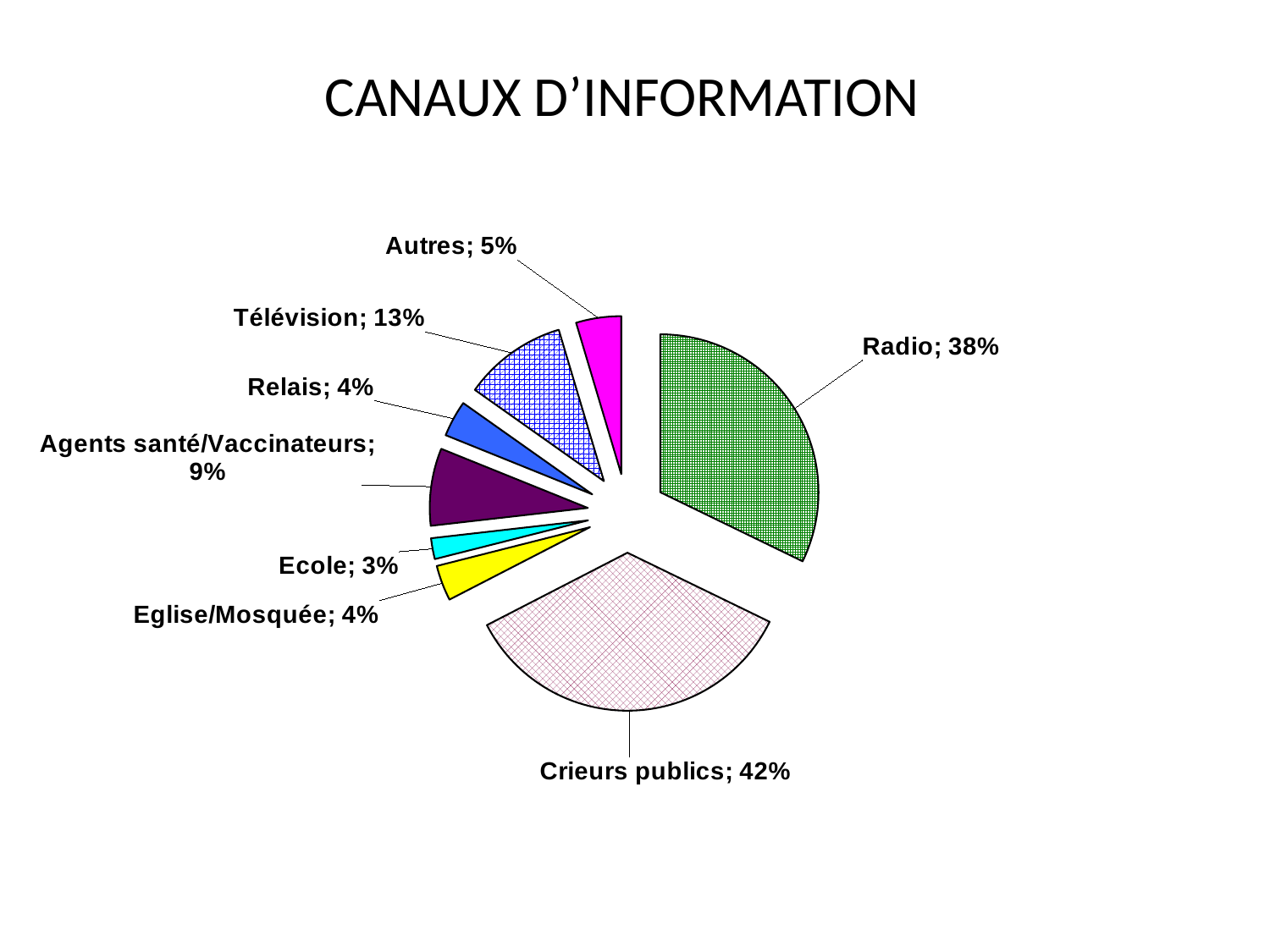
Which category has the largest share of the pie? Crieurs publics How many categories are shown in the pie chart? 8 What percentage is shown for Agents santé/Vaccinateurs? 9% What is the title of the chart? CANAUX D'INFORMATION What percentage is shown for Ecole? 3% What percentage is shown for Radio? 38% What is the difference between the shares of Crieurs publics and Radio? 4% Which is larger, the share for Télévision or the share for Agents santé/Vaccinateurs? Télévision What type of chart is shown on the slide? pie chart What percentage is shown for Télévision? 13% Which category has the smallest share of the pie? Ecole What is the combined share of Relais and Eglise/Mosquée? 8%